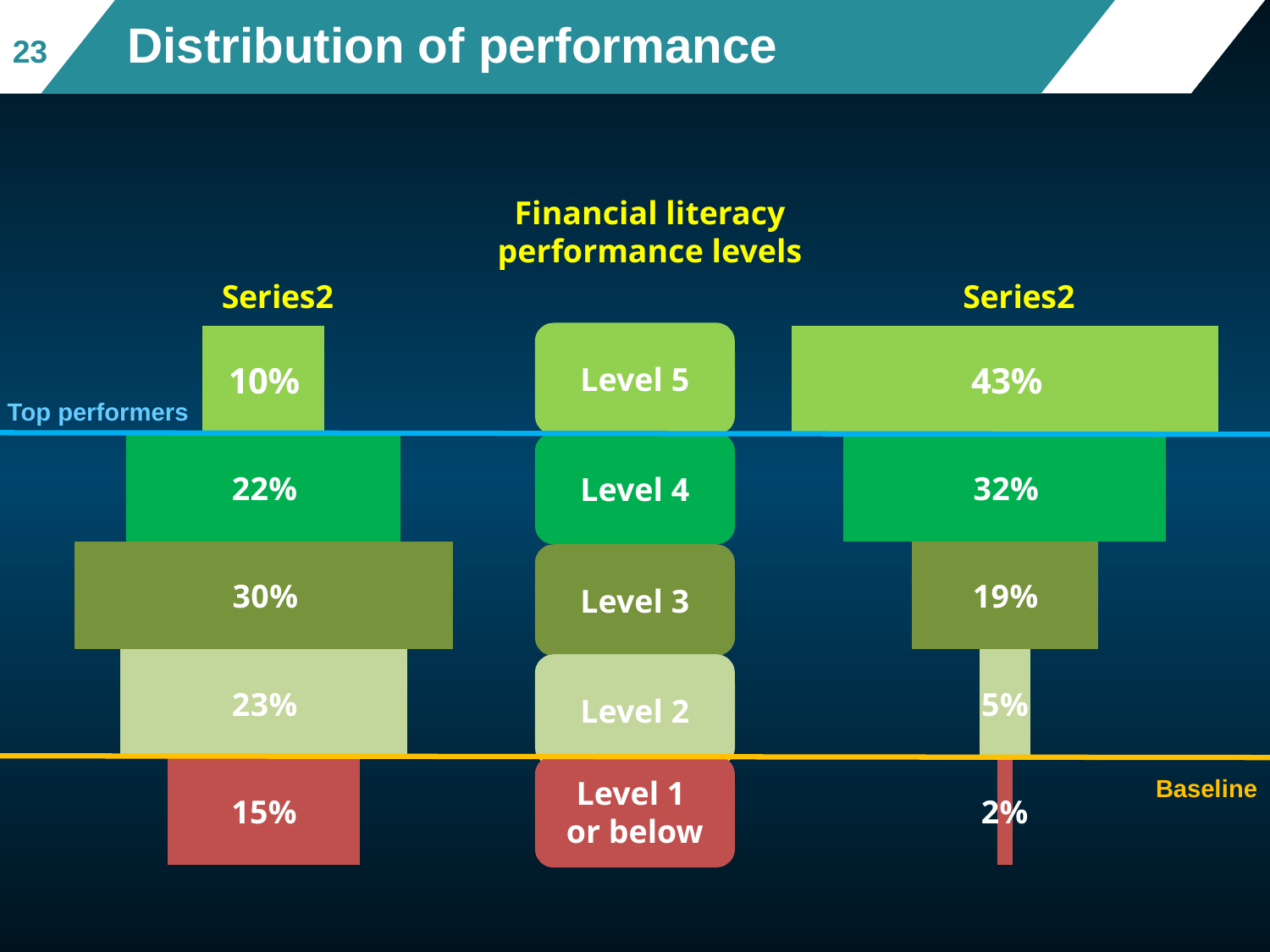
What kind of chart is the right chart? Bar chart In the left chart, what is the value for Level 1 or below? 15% Which is larger: the value for Level 4 in the left chart or the value for Level 4 in the right chart? Right chart In the right chart, which level has the lowest value? Level 1 or below What is the title shown above the central level labels? Financial literacy performance levels How many performance levels are shown in the left chart? 5 In the right chart, what is the difference between the values for Level 5 and Level 4? 11% In the right chart, what is the value for Level 5? 43% In the left chart, what is the value for Level 3? 30% In the left chart, what is the difference between the values for Level 2 and Level 5? 13% In the left chart, which level has the highest value? Level 3 In the right chart, what is the value for Level 2? 5%